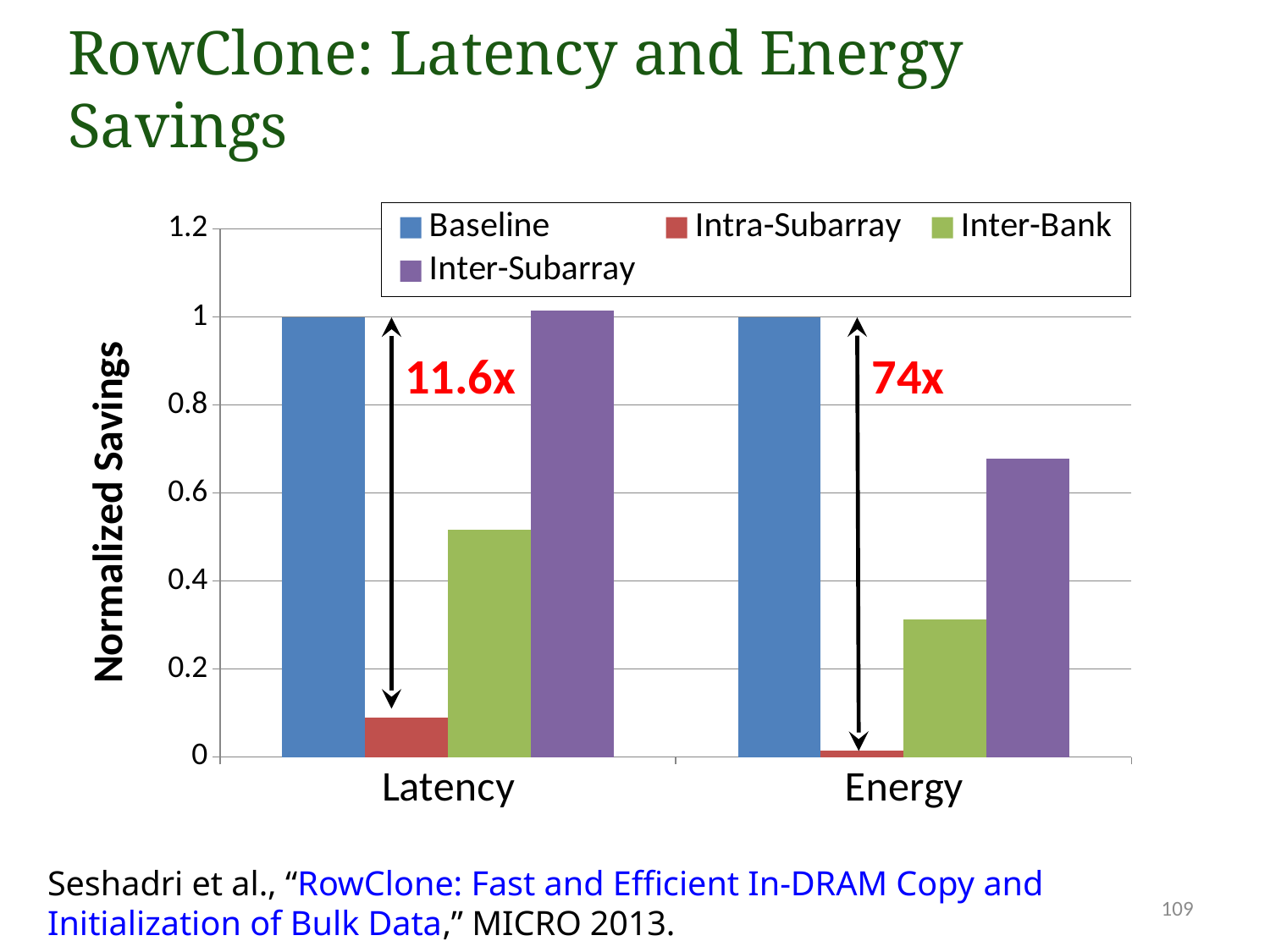
What is the title of the y axis? Normalized Savings How many categories are shown on the x axis? 2 For Latency, which is larger: Inter-Bank or Inter-Subarray? Inter-Subarray How many series does the legend list? 4 What is the Baseline value for Latency? 1 What is the Baseline value for Energy? 1 Is the Intra-Subarray value for Latency greater or less than 0.2? less Is the Inter-Bank value for Latency greater or less than 0.4? greater What kind of chart is shown on the slide? bar chart Which series has the lowest value for Energy? Intra-Subarray Is the Inter-Subarray value for Energy greater or less than 0.6? greater What improvement factor is annotated above the Energy bars? 74x